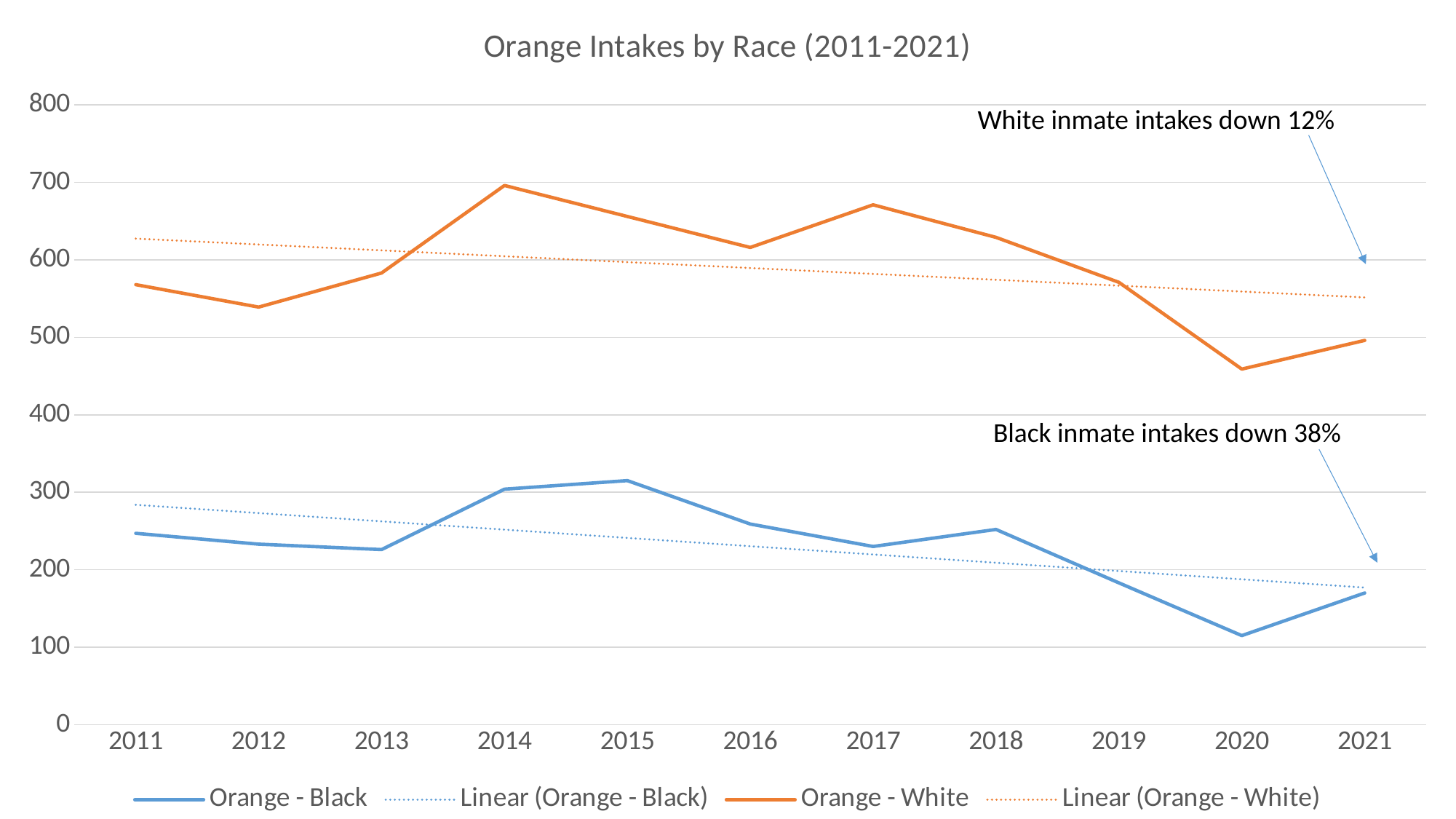
How many series does the legend list? 4 Is the Orange - White value for 2020 greater or less than 500? less In which year does the Orange - Black series reach its lowest value? 2020 How many years are plotted along the x axis? 11 Which series has the higher value in 2017, Orange - Black or Orange - White? Orange - White In which year does the Orange - White series reach its highest value? 2014 According to the annotation on the chart, by what percentage are White inmate intakes down? 12% Is the Orange - White value for 2014 greater or less than 600? greater What type of chart is shown on the slide? Line chart In which year does the Orange - White series reach its lowest value? 2020 What is the title of the chart? Orange Intakes by Race (2011-2021) Is the Orange - Black value for 2020 greater or less than 200? less